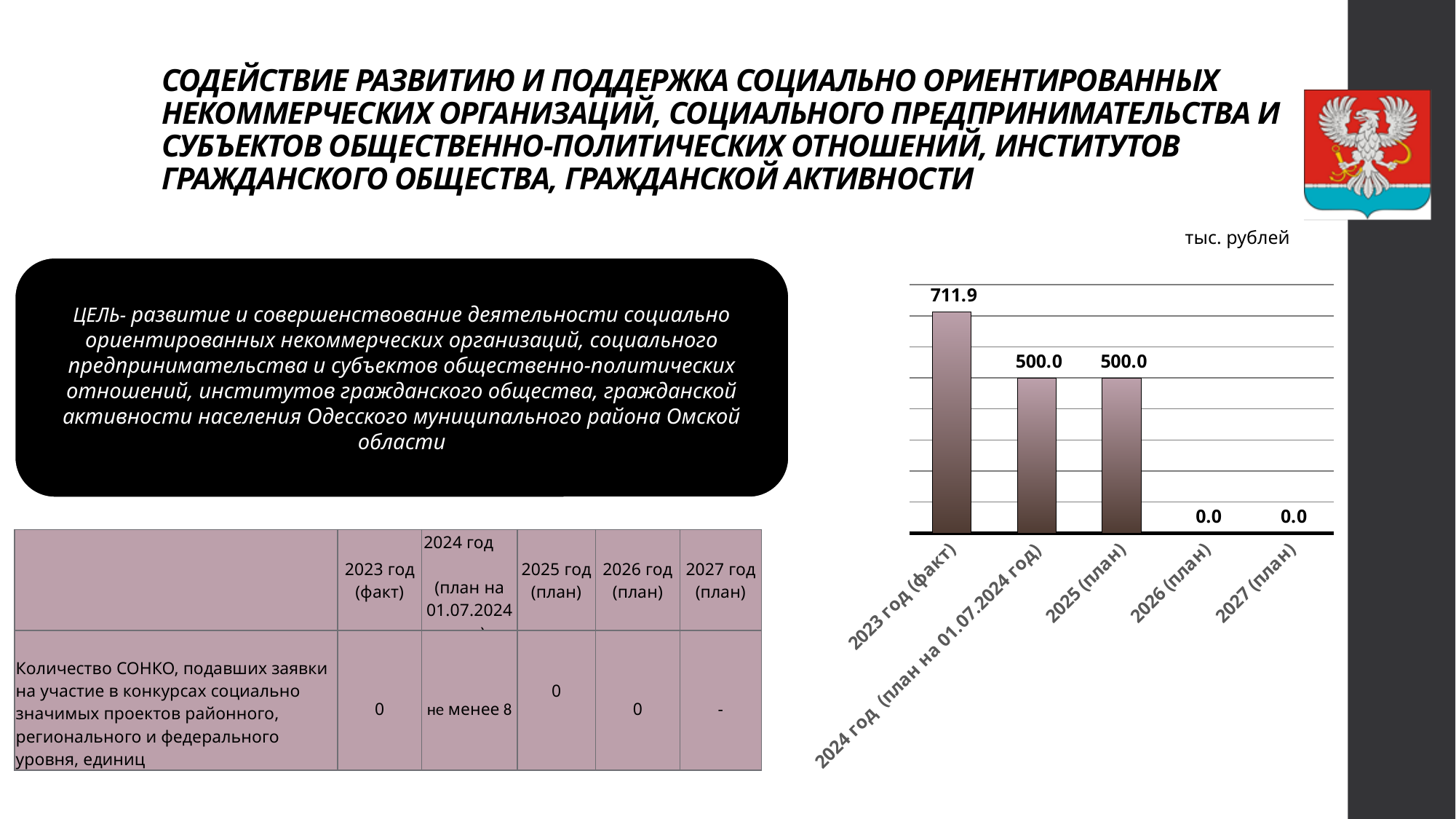
Which category has the highest value on the chart? 2023 год (факт) How many categories on the chart have a value of 0.0? 2 What is the value for 2024 год (план на 01.07.2024 год) on the chart? 500.0 What unit is indicated above the chart? тыс. рублей What kind of chart is shown on the slide? bar chart What is the value for 2025 (план) on the chart? 500.0 What is the value for 2026 (план) on the chart? 0.0 What is the value for 2023 год (факт) on the chart? 711.9 What is the difference between the values for 2023 год (факт) and 2025 (план)? 211.9 How many categories are shown on the chart? 5 Which is larger: the value for 2023 год (факт) or the value for 2024 год (план на 01.07.2024 год)? 2023 год (факт) Do the values on the chart rise or fall from 2023 год (факт) to 2027 (план)? fall